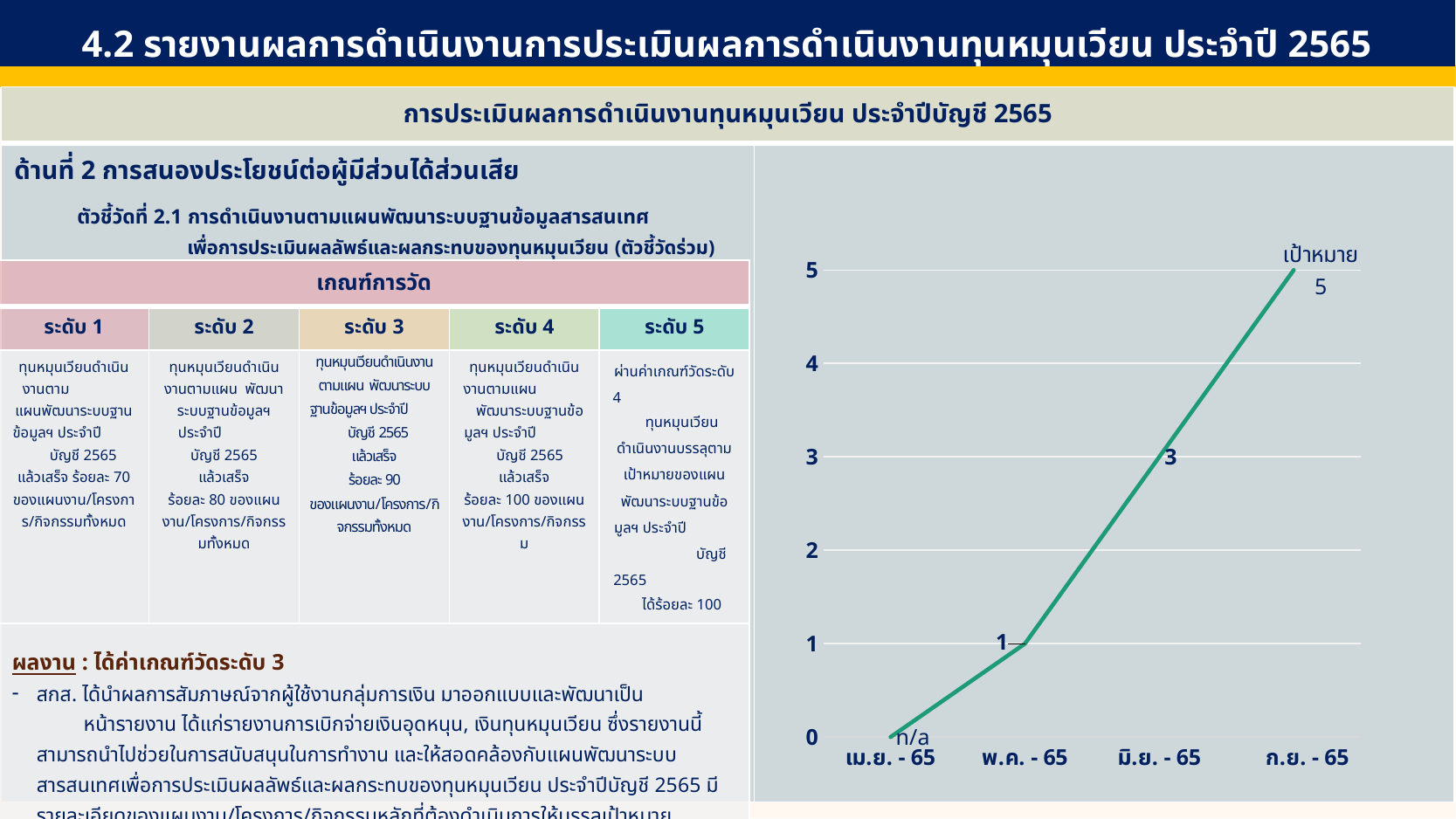
What data label is shown for เม.ย. - 65 in the line chart? n/a Which is larger in the line chart, the value for มิ.ย. - 65 or the value for พ.ค. - 65? มิ.ย. - 65 What kind of chart is shown on the right side of the slide? line chart How many categories are shown on the x axis of the line chart? 4 What is the value plotted for พ.ค. - 65 in the line chart? 1 What is the difference between the values for ก.ย. - 65 and มิ.ย. - 65 in the line chart? 2 What is the value plotted for มิ.ย. - 65 in the line chart? 3 What is the value plotted for ก.ย. - 65 in the line chart? 5 Which category has the highest value in the line chart? ก.ย. - 65 What is the difference between the values for มิ.ย. - 65 and พ.ค. - 65 in the line chart? 2 Do the values in the line chart rise or fall from left to right along the x axis? rise What label is written next to the last point of the line chart? เป้าหมาย